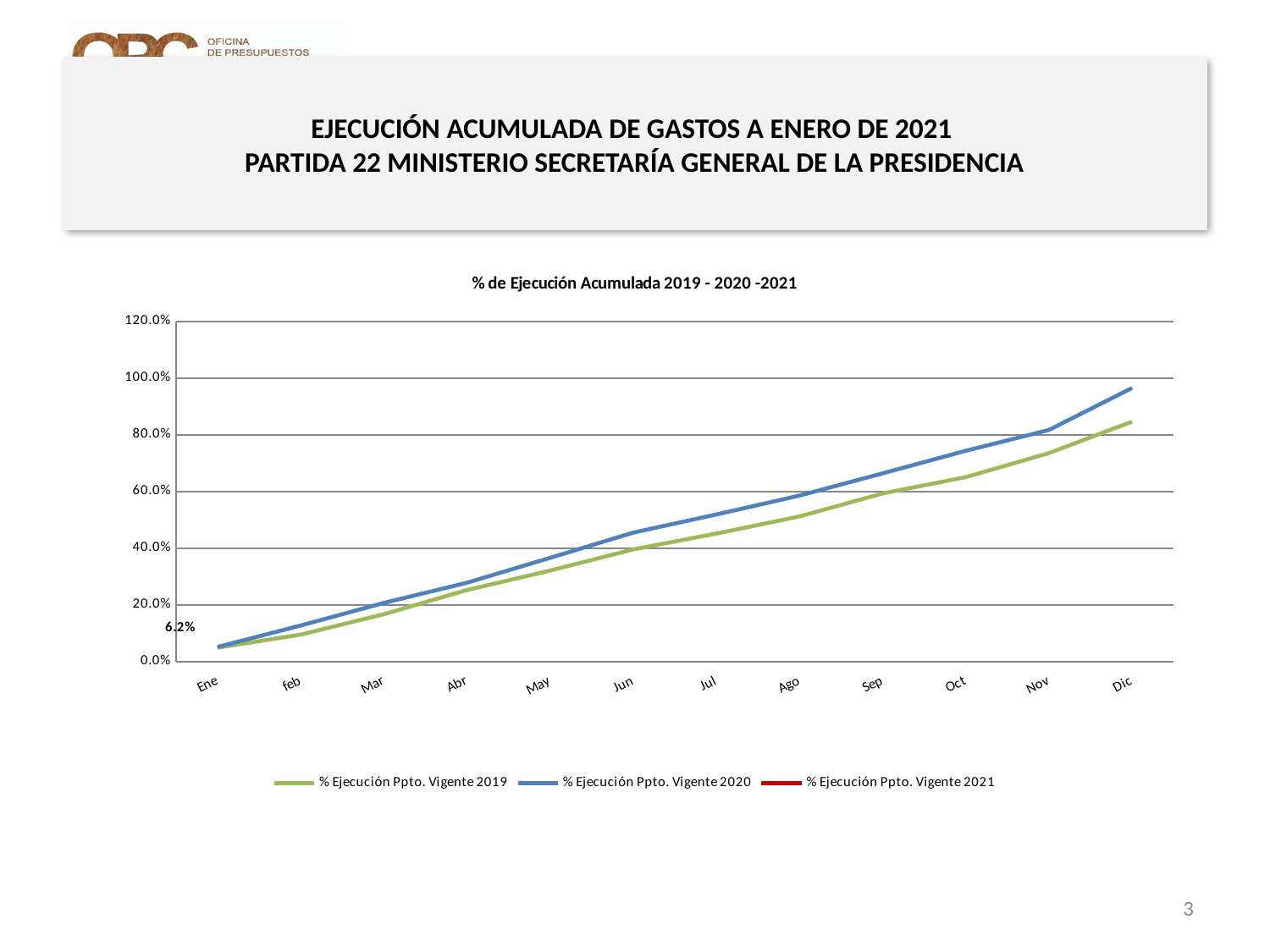
What type of chart is shown on the slide? line chart What colour is the line for % Ejecución Ppto. Vigente 2020? blue Do the values for % Ejecución Ppto. Vigente 2020 rise or fall from Ene to Dic? rise What is the title of the chart? % de Ejecución Acumulada 2019 - 2020 -2021 In which month does % Ejecución Ppto. Vigente 2019 reach its highest value? Dic Is the value for % Ejecución Ppto. Vigente 2019 in Dic greater or less than 100.0%? less Which series is higher in Dic, % Ejecución Ppto. Vigente 2019 or % Ejecución Ppto. Vigente 2020? % Ejecución Ppto. Vigente 2020 Is the value for % Ejecución Ppto. Vigente 2020 in Dic greater or less than 80.0%? greater What value is printed as a data label for % Ejecución Ppto. Vigente 2021 in Ene? 6.2% Is the value for % Ejecución Ppto. Vigente 2019 in Jun greater or less than 60.0%? less How many series does the legend list? 3 How many months are shown on the x axis? 12